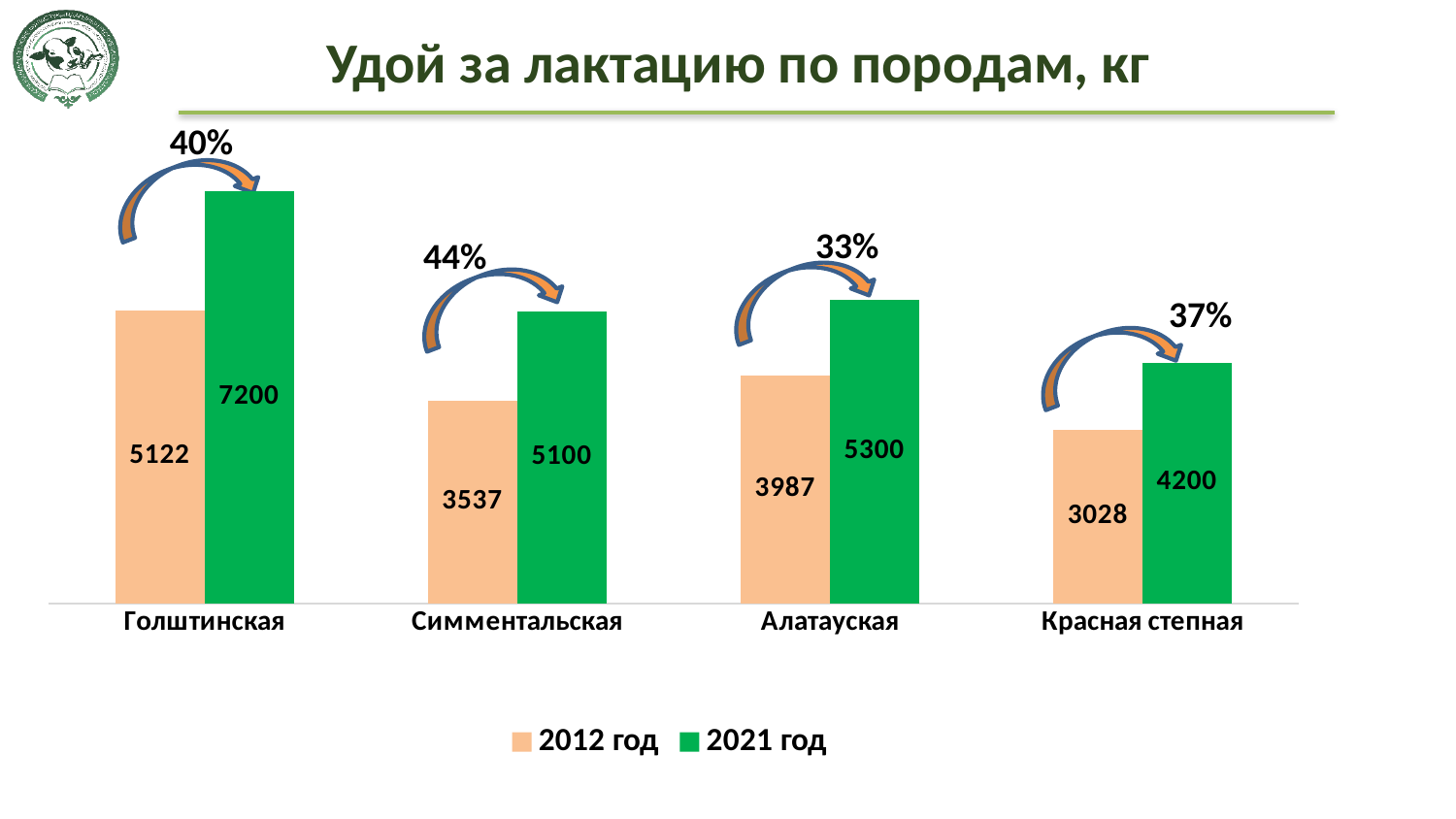
Which is larger: the 2021 год value for Симментальская or the 2021 год value for Алатауская? Алатауская Which breed has the highest 2021 год value? Голштинская What is the title of the chart? Удой за лактацию по породам, кг What is the 2021 год value for Симментальская? 5100 What is the 2012 год value for Голштинская? 5122 What is the difference between the 2021 год and 2012 год values for Алатауская? 1313 What percentage increase is shown above the bars for Симментальская? 44% What is the 2012 год value for Красная степная? 3028 How many breeds are shown on the x axis? 4 What kind of chart is shown on the slide? Bar chart Which breed has the lowest 2012 год value? Красная степная How many series does the legend list? 2